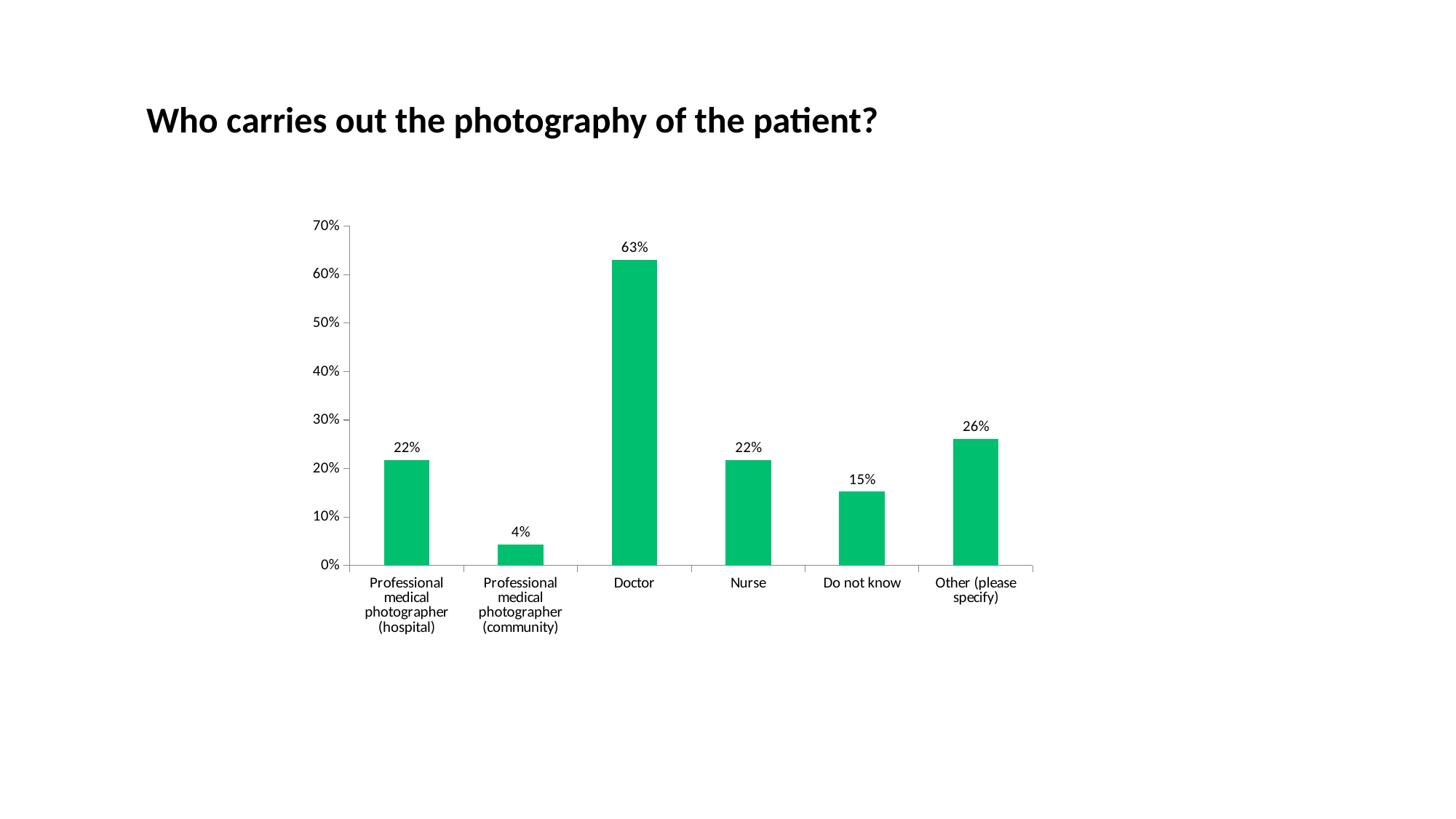
What percentage is shown for Doctor? 63% What percentage is shown for Professional medical photographer (community)? 4% How many categories are shown on the x axis? 6 What is the difference between the values for Doctor and Nurse? 41% Which category has the highest value? Doctor What is the title of the slide? Who carries out the photography of the patient? What kind of chart is shown on the slide? bar chart Which category has the lowest value? Professional medical photographer (community) What percentage is shown for Do not know? 15% What percentage is shown for Other (please specify)? 26% Which is larger, the value for Other (please specify) or the value for Do not know? Other (please specify) Is the value for Doctor greater or less than 50%? greater